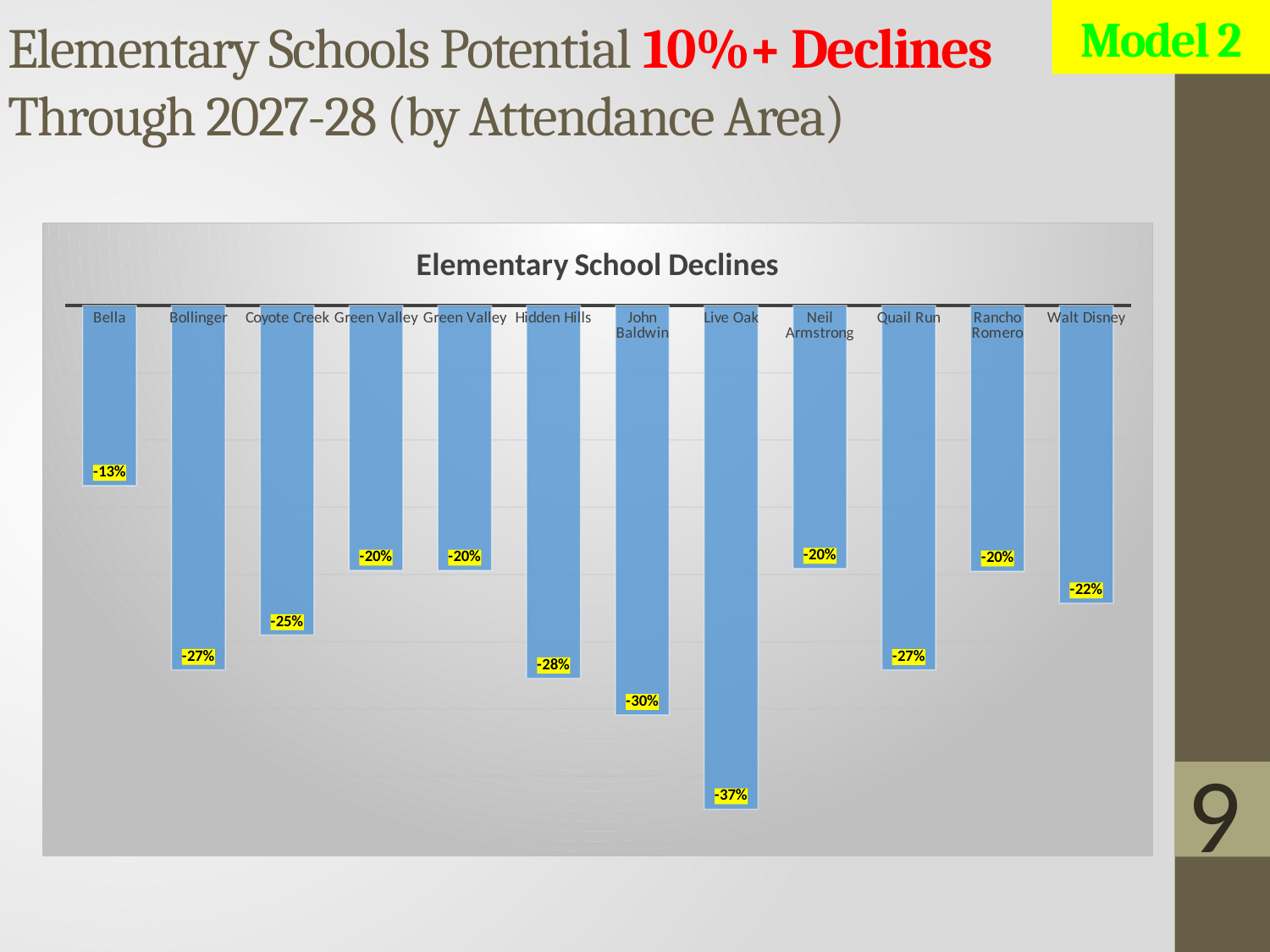
What is the value shown for Bella in the Elementary School Declines chart? -13% What is the value shown for Coyote Creek in the Elementary School Declines chart? -25% Which school has the smallest decline in the Elementary School Declines chart? Bella What is the value shown for Walt Disney in the Elementary School Declines chart? -22% What is the value shown for Live Oak in the Elementary School Declines chart? -37% What is the difference between the declines for Live Oak and Bella in the Elementary School Declines chart? 24 percentage points What kind of chart is the Elementary School Declines chart? Bar chart Which school shows a larger decline, Hidden Hills or Neil Armstrong? Hidden Hills How many bars are plotted in the Elementary School Declines chart? 12 Which school has the largest decline in the Elementary School Declines chart? Live Oak What is the title of the chart on the slide? Elementary School Declines What is the value shown for John Baldwin in the Elementary School Declines chart? -30%